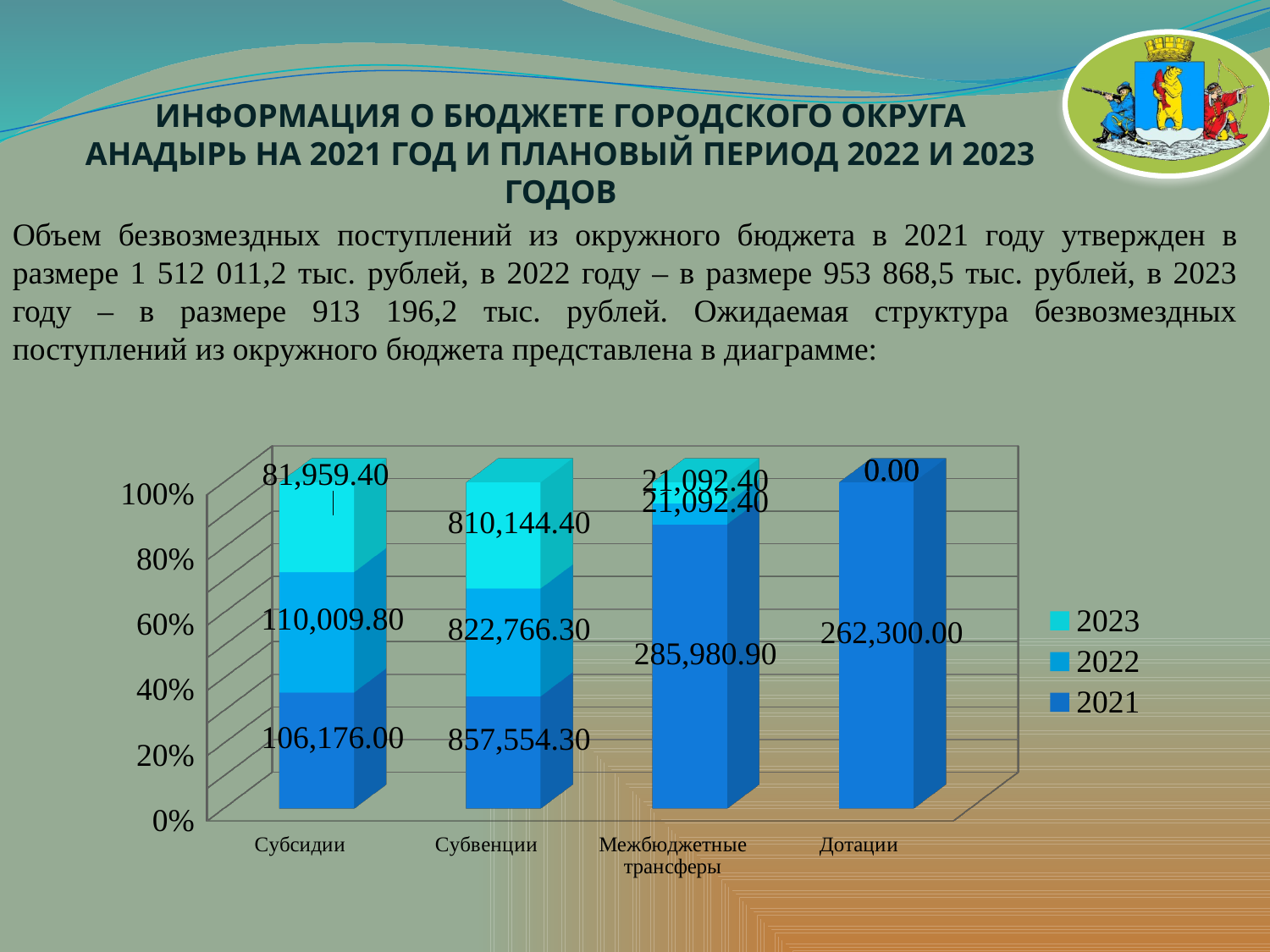
What is the value for 2021 in the Субсидии category? 106,176.00 How many categories are shown on the x axis? 4 What is the value for 2021 in the Межбюджетные трансферы category? 285,980.90 How many series does the legend list? 3 What is the value for 2023 in the Субвенции category? 810,144.40 Which is larger for Субсидии, the 2021 value or the 2022 value? 2022 What is the value for 2022 in the Субвенции category? 822,766.30 Which category has the highest 2021 value? Субвенции What is the value for 2023 in the Субсидии category? 81,959.40 What is the difference between the 2021 and 2022 values for Субвенции? 34,788.00 What is the value for 2021 in the Дотации category? 262,300.00 What kind of chart is shown on the slide? Stacked bar chart